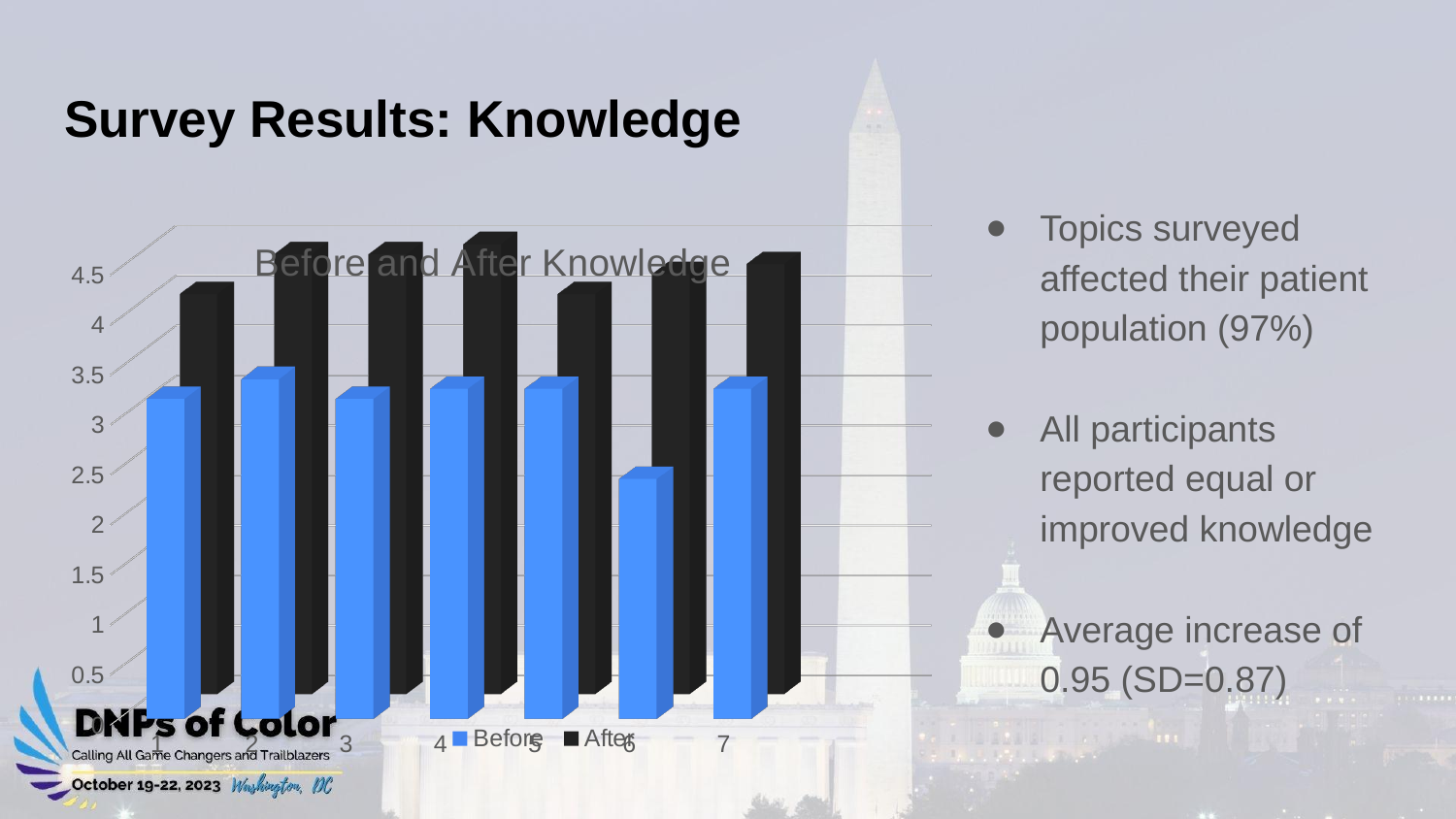
Is the Before value for category 6 greater or less than 2? greater How many categories are shown along the x axis of the chart? 7 Which series is shown in blue in the chart? Before Is the Before value for category 2 greater or less than 3? greater What is the title of the chart? Before and After Knowledge What kind of chart is shown on the slide? bar chart For category 1, which is larger, the Before value or the After value? After Which category has the lowest Before value? 6 How many series does the chart legend list? 2 Is the Before value for category 6 greater or less than 3? less For category 6, which is larger, the Before value or the After value? After